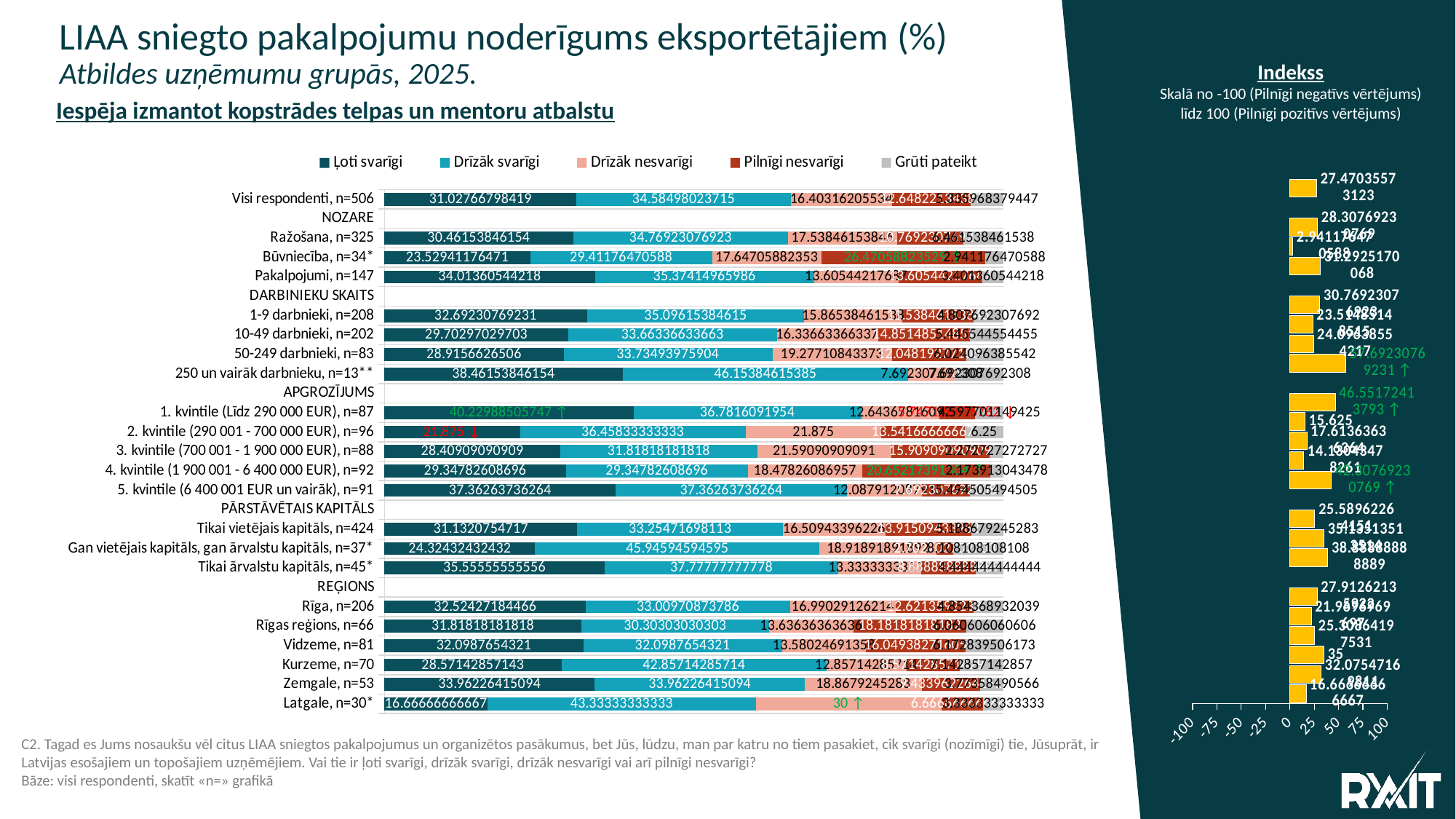
In the main chart, which category has the lowest 'Ļoti svarīgi' value? Latgale, n=30* In the main chart, what is the difference between the 'Drīzāk svarīgi' and 'Ļoti svarīgi' values for 'Kurzeme, n=70'? 14.28571428571 In the main chart, what is the 'Drīzāk nesvarīgi' value for 'Latgale, n=30*'? 30 In the main chart, what is the total of all five segments for '2. kvintile (290 001 - 700 000 EUR), n=96'? 100 In the main chart, what is the 'Ļoti svarīgi' value for 'Visi respondenti, n=506'? 31.02766798419 What kind of chart is used to show the importance ratings for 'Iespēja izmantot kopstrādes telpas un mentoru atbalstu'? Stacked bar chart In the main chart, which has the larger 'Ļoti svarīgi' value: 'Pakalpojumi, n=147' or 'Ražošana, n=325'? Pakalpojumi, n=147 In the main chart, what is the 'Drīzāk svarīgi' value for '250 un vairāk darbinieku, n=13**'? 46.15384615385 In the main chart, which category has the highest 'Ļoti svarīgi' value? 1. kvintile (Līdz 290 000 EUR), n=87 How many series does the legend of the main chart list? 5 How many category rows are listed under the 'REĢIONS' group in the main chart? 6 In the 'Indekss' chart on the right, is the value for 'Latgale, n=30*' greater or less than 25? less